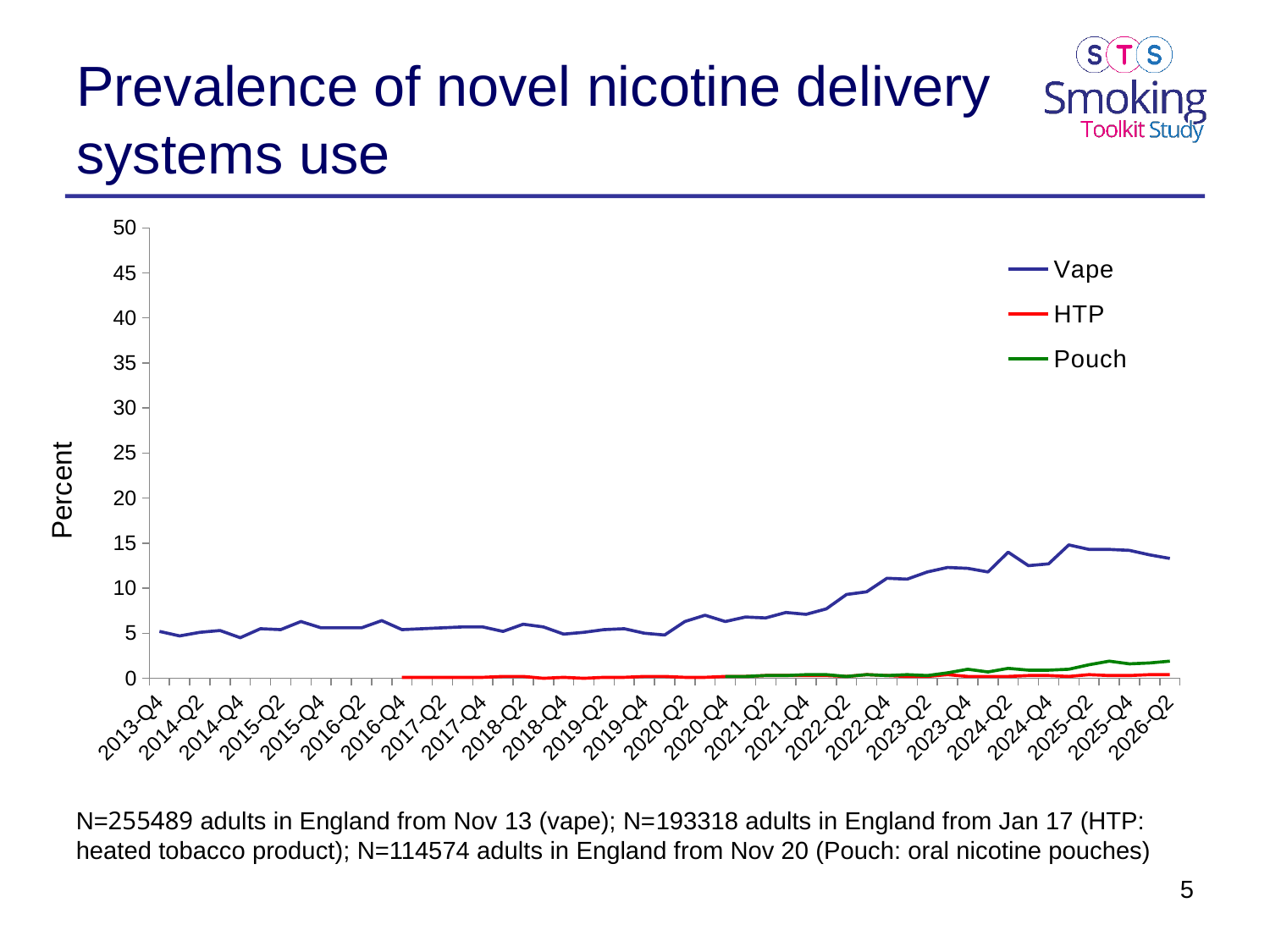
How many series does the legend list? 3 At 2026-Q2, which is larger, the value for Vape or the value for Pouch? Vape Is the value for Pouch at 2026-Q2 greater or less than 5? less What colour is the Pouch line in the legend? Green Which series has the highest values across the chart? Vape Which series has the lowest values at 2026-Q2? HTP Is the value for Vape at 2013-Q4 greater or less than 10? less What is the last label on the x axis? 2026-Q2 What kind of chart is shown on the slide? Line chart Is the value for Vape at 2025-Q2 greater or less than 10? greater Does the Vape line rise or fall between 2020-Q2 and 2025-Q2? Rise What is the label on the y axis? Percent